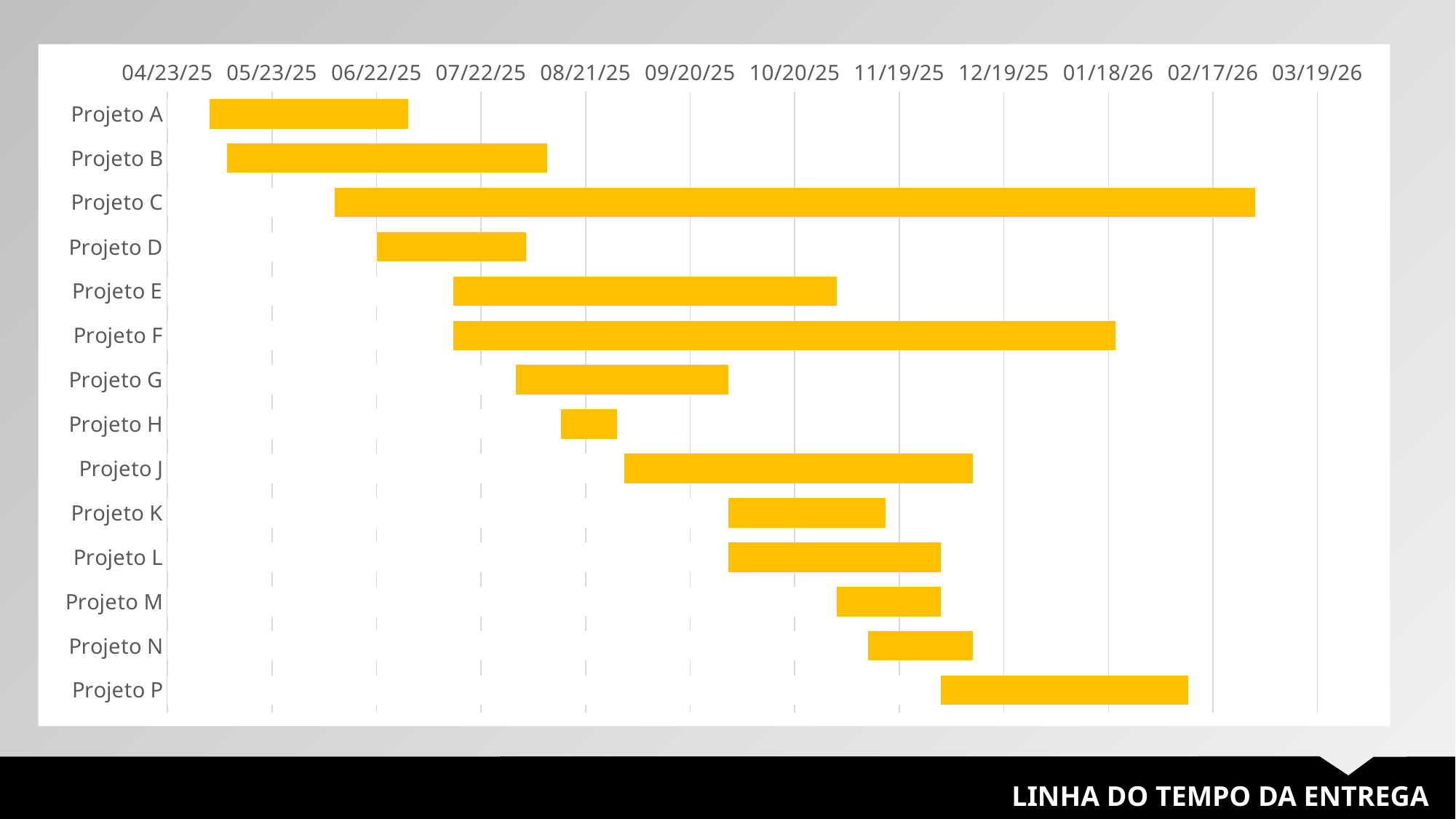
Does the bar for Projeto H start before or after 08/21/25? before Does the bar for Projeto C end before or after 02/17/26? after Which project has the longest bar (longest duration) in the chart? Projeto C Which has the longer bar, Projeto E or Projeto F? Projeto F Which has the longer bar, Projeto K or Projeto L? Projeto L Which project has the shortest bar (shortest duration) in the chart? Projeto H Which project ends latest in the timeline? Projeto C Does the bar for Projeto A start before or after 05/23/25? before How many projects are listed on the vertical axis of the chart? 14 What kind of chart is shown on the slide? bar chart What title text appears in the black band at the bottom of the slide? LINHA DO TEMPO DA ENTREGA Which project starts earliest in the timeline? Projeto A